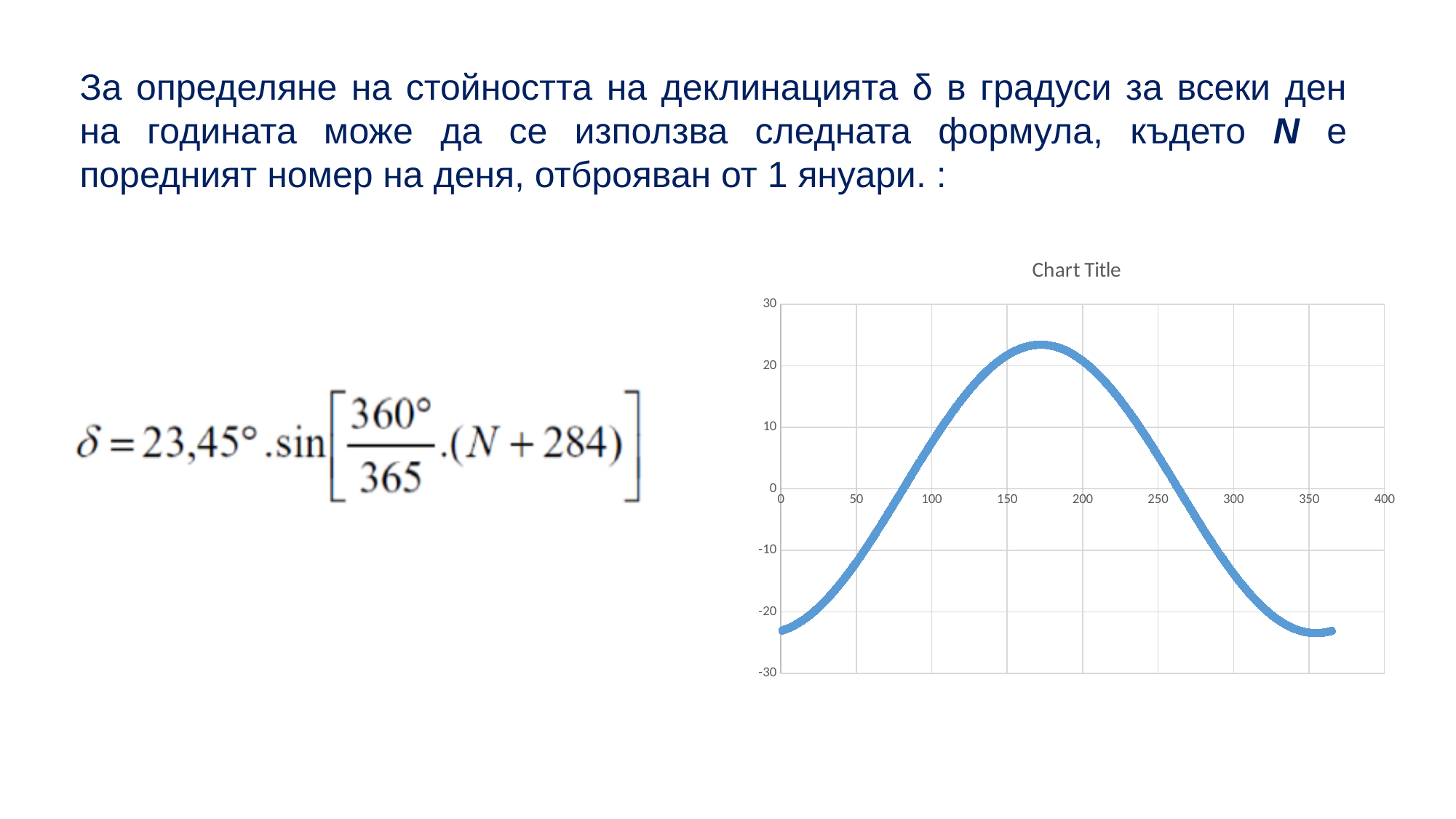
What kind of chart is shown on the slide? line chart Is the lowest value of the curve greater or less than -20? less Is the peak value of the curve greater or less than 20? greater Is the value of the curve at x = 250 greater or less than 0? greater What is the title of the chart? Chart Title What is the highest value shown on the chart's vertical axis? 30 Does the curve rise or fall as x goes from 0 to 150? rise Does the curve rise or fall as x goes from 200 to 350? fall